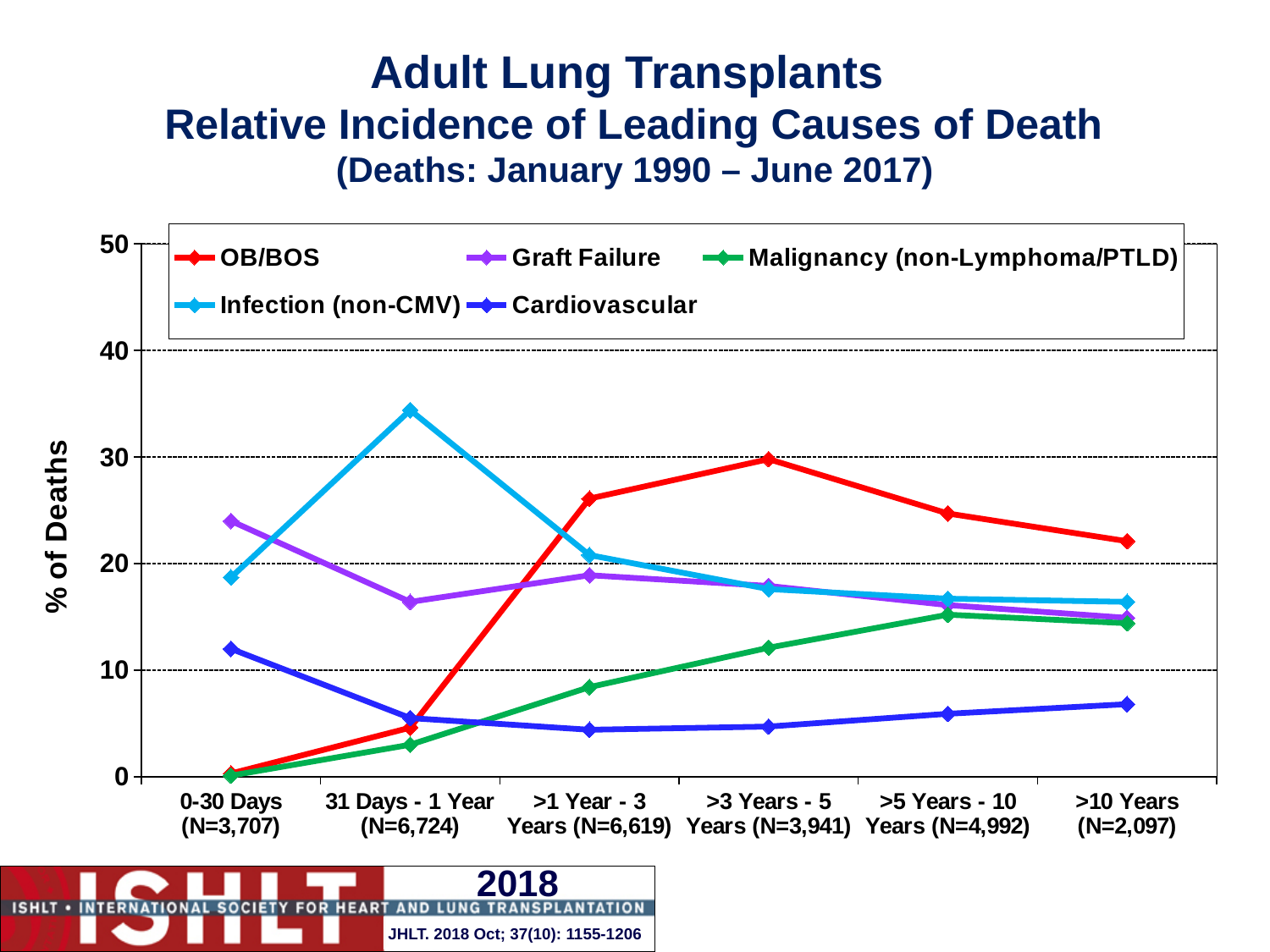
Is the value for Infection (non-CMV) at 31 Days - 1 Year greater or less than 30? greater Which cause of death has the highest % of deaths in the >3 Years - 5 Years period? OB/BOS What kind of chart is shown on the slide? line chart Does the Malignancy (non-Lymphoma/PTLD) line rise or fall from 0-30 Days to >10 Years? rise At 0-30 Days, which is larger: Graft Failure or Cardiovascular? Graft Failure What is the N shown for the >10 Years category? N=2,097 Is the value for Graft Failure at 0-30 Days greater or less than 20? greater Is the value for Cardiovascular at >1 Year - 3 Years greater or less than 10? less How many time-period categories are shown on the x axis? 6 How many series does the legend list? 5 Which cause of death has the highest % of deaths in the 31 Days - 1 Year period? Infection (non-CMV)